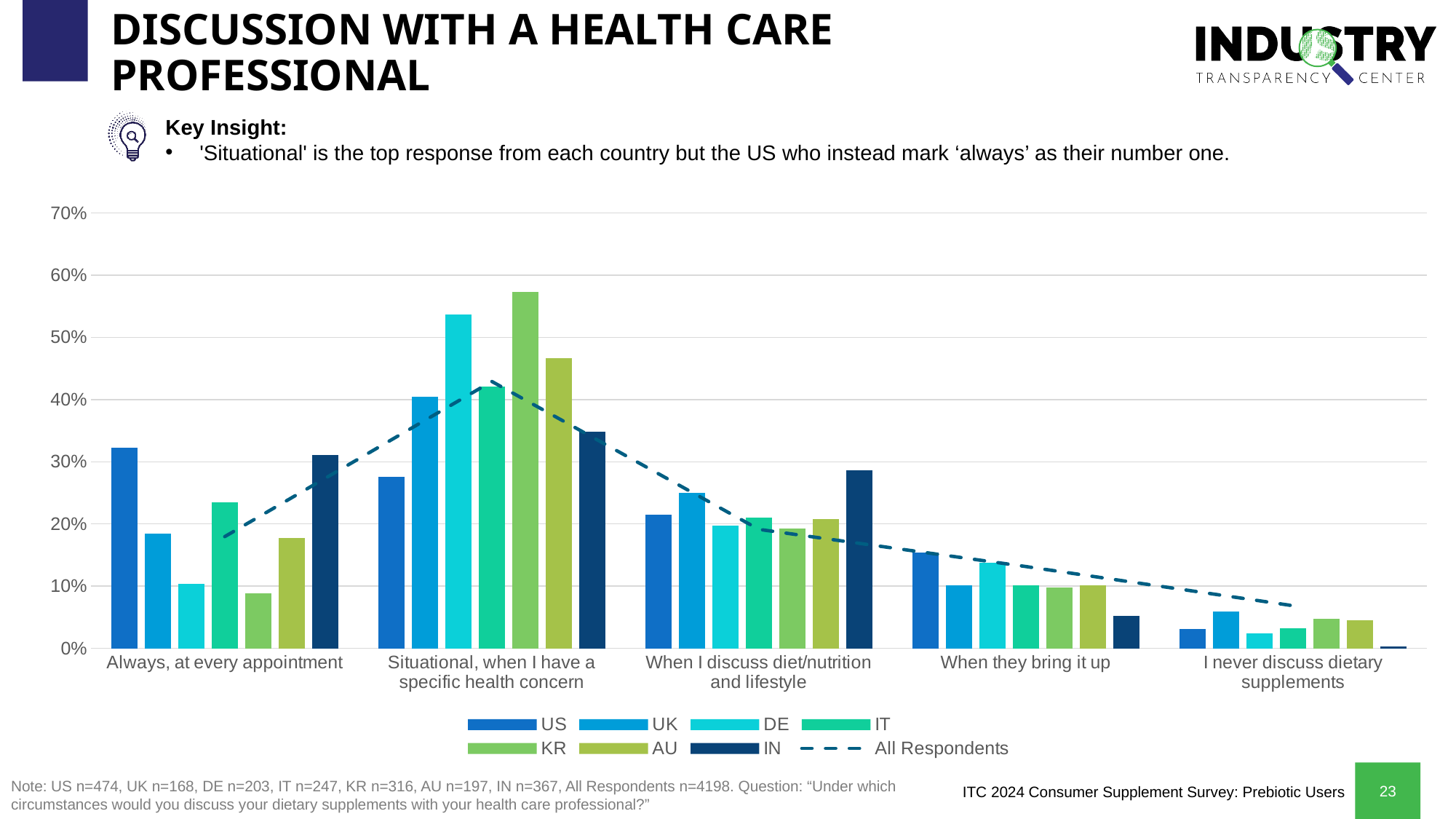
Does the All Respondents dashed line rise or fall from 'Situational, when I have a specific health concern' to 'I never discuss dietary supplements'? fall Which country has the highest bar for 'When I discuss diet/nutrition and lifestyle'? IN Which country has the lowest bar for 'I never discuss dietary supplements'? IN Under 'Situational, when I have a specific health concern', which is larger, DE or UK? DE What kind of chart is shown on the slide? combination bar and line chart How many response categories are shown along the x axis? 5 Is the value for IN under 'When they bring it up' greater or less than 10%? less How many entries does the legend list? 8 Which country has the highest bar for 'Situational, when I have a specific health concern'? KR Which country has the highest bar for 'When they bring it up'? US Is the value for US under 'Always, at every appointment' greater or less than 30%? greater Is the value for KR under 'Situational, when I have a specific health concern' greater or less than 50%? greater